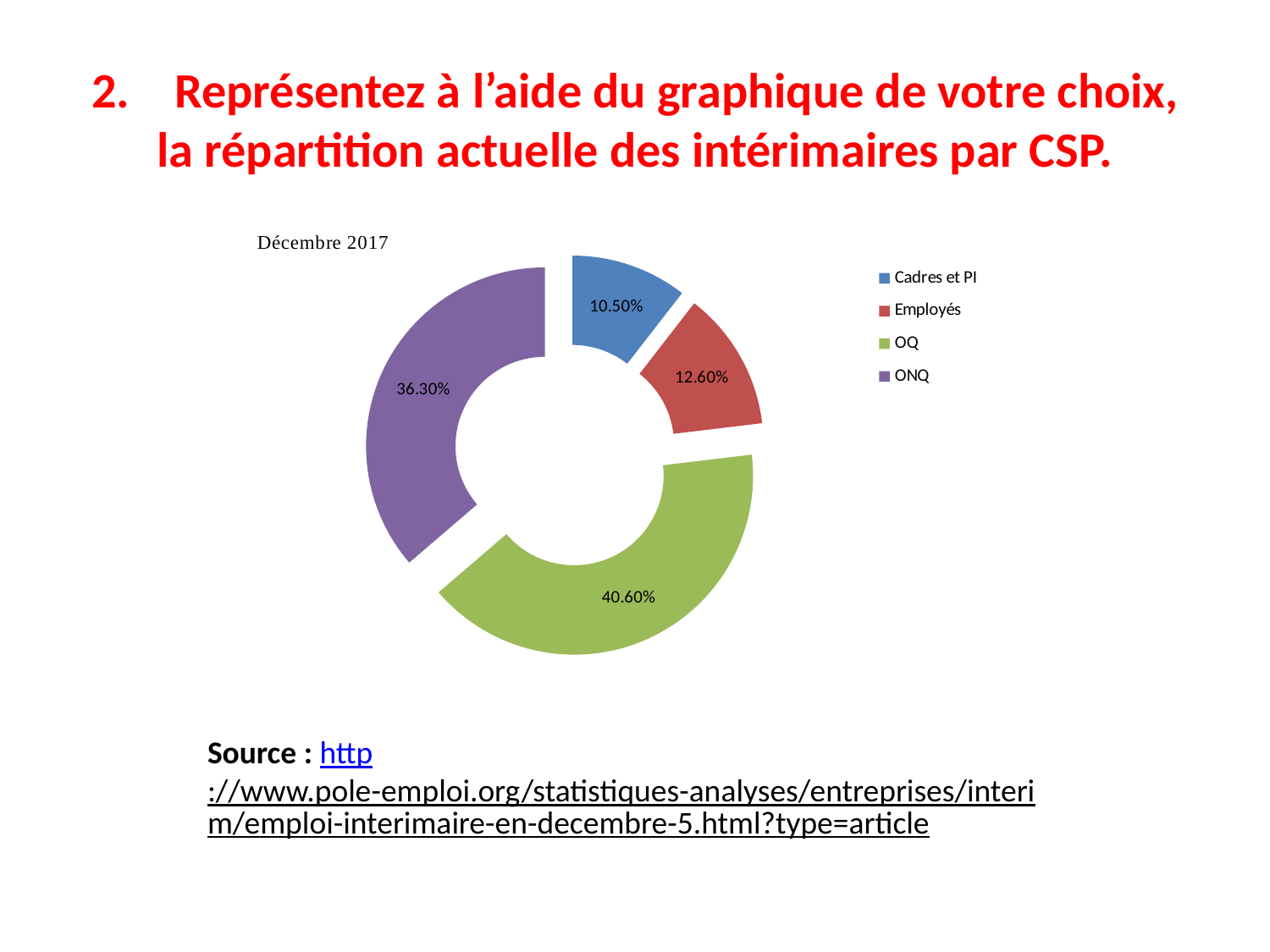
What kind of chart is shown on the slide? Doughnut (pie) chart What is the difference between the shares of OQ and ONQ? 4.30% What is the share for ONQ? 36.30% What is the title shown above the chart? Décembre 2017 Which category has the smallest share? Cadres et PI Which category has the largest share? OQ What is the share for Cadres et PI? 10.50% What is the share for OQ? 40.60% What is the share for Employés? 12.60% How many categories does the chart show? 4 Which colour represents ONQ in the chart? Purple Which is larger, the share for Employés or the share for Cadres et PI? Employés